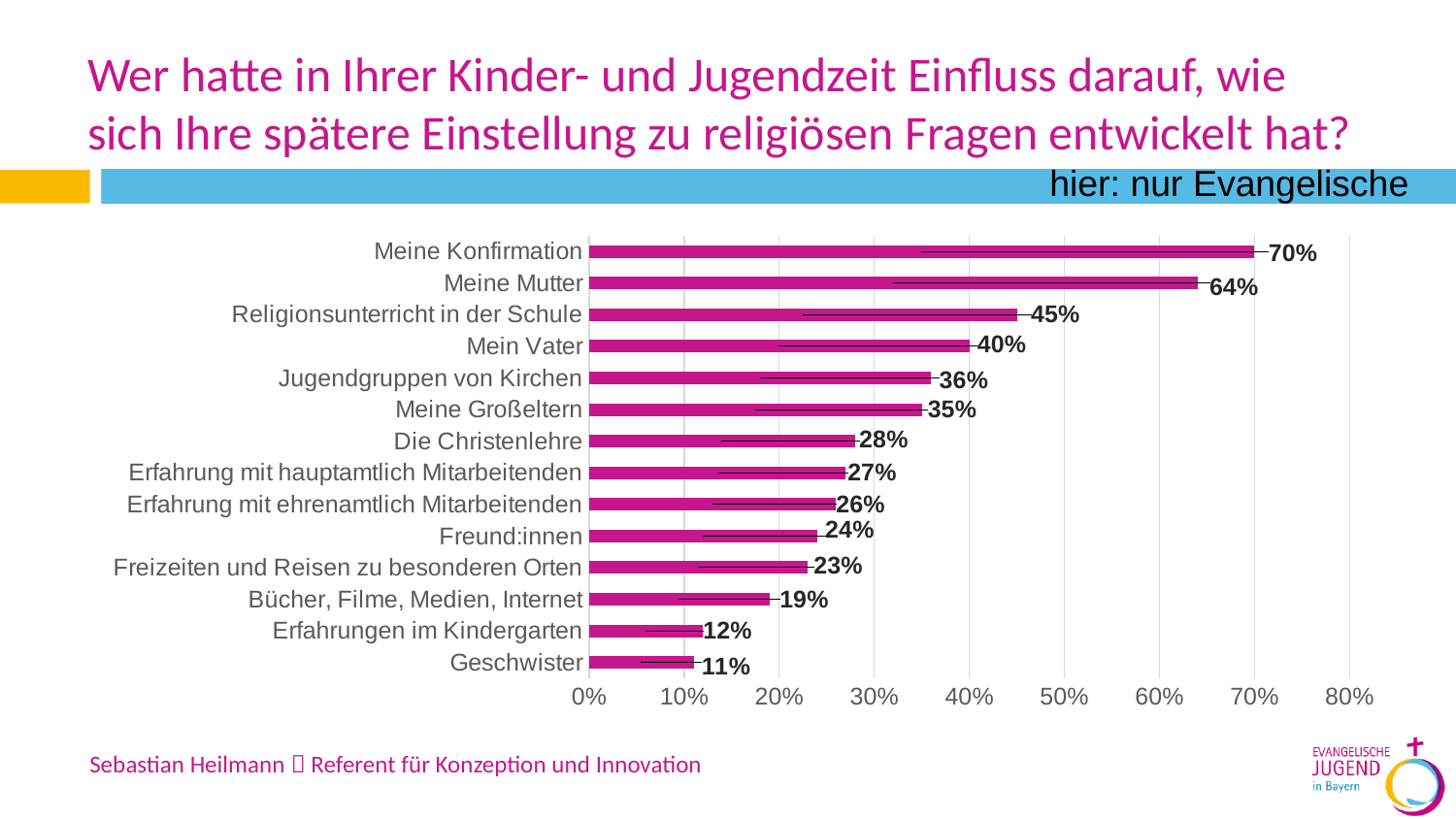
Is the value for Freund:innen greater or less than 30%? less What subgroup does the chart refer to, according to the subtitle? nur Evangelische What kind of chart is shown on the slide? bar chart What is the value for Geschwister? 11% What is the value for Erfahrungen im Kindergarten? 12% Which category has the lowest value? Geschwister What is the value for Meine Konfirmation? 70% How many categories are shown in the chart? 14 Which category has the highest value? Meine Konfirmation What is the difference between the values for Meine Mutter and Mein Vater? 24% What is the value for Religionsunterricht in der Schule? 45% Which is larger, the value for Jugendgruppen von Kirchen or the value for Die Christenlehre? Jugendgruppen von Kirchen